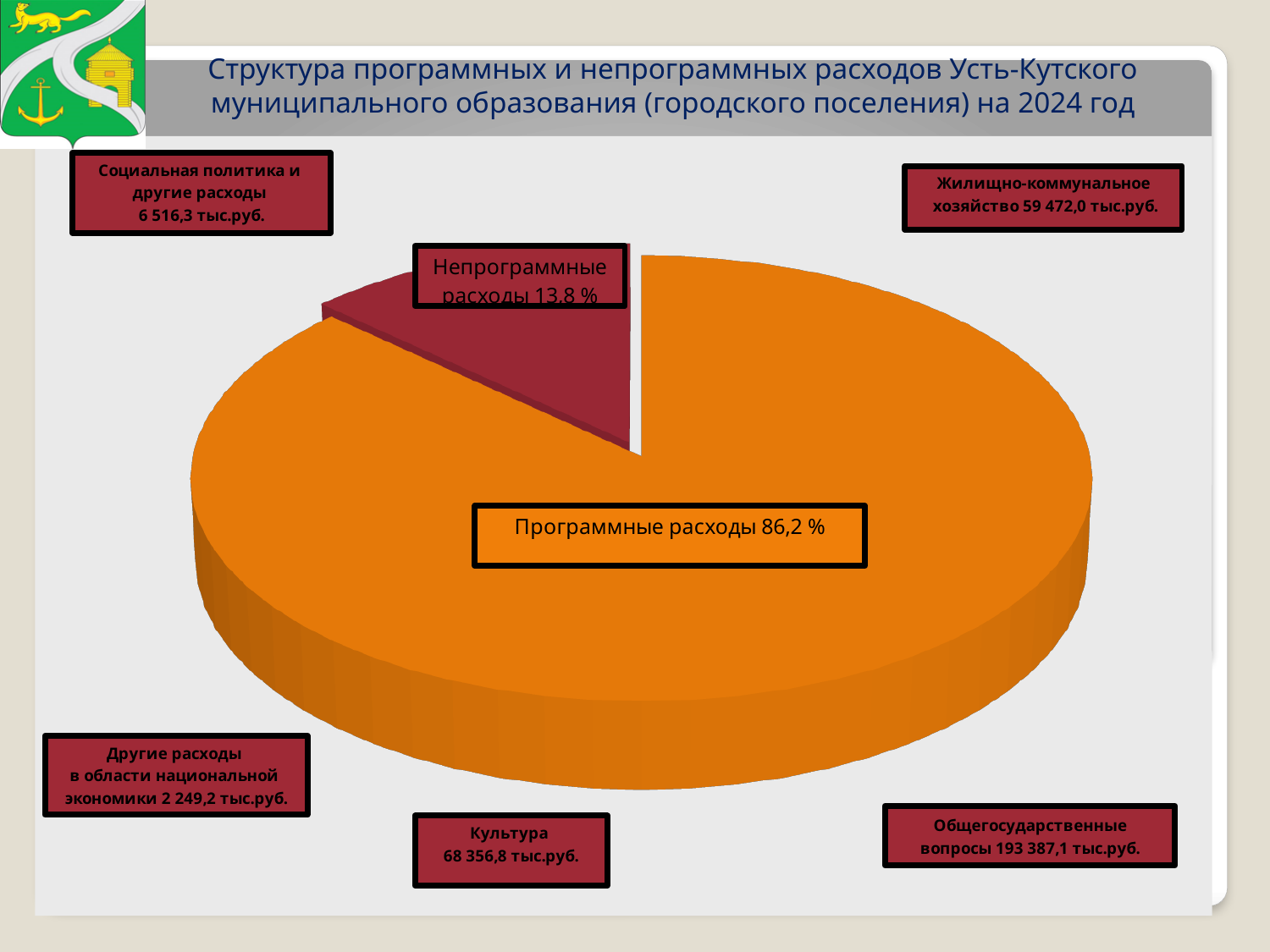
What percentage of the pie is labelled for Непрограммные расходы? 13,8 % What share of the pie does Непрограммные расходы take? 13,8 % What year does the chart title refer to? 2024 How many slices does the pie chart have? 2 What colour is the Непрограммные расходы slice? Dark red Which slice of the pie chart is the smallest? Непрограммные расходы What percentage of the pie is labelled for Программные расходы? 86,2 % Which slice of the pie chart is the largest? Программные расходы What kind of chart is shown on the slide? Pie chart Which is larger, Программные расходы or Непрограммные расходы? Программные расходы What do the two labelled slice percentages add up to? 100 % By how many percentage points does Программные расходы exceed Непрограммные расходы? 72,4